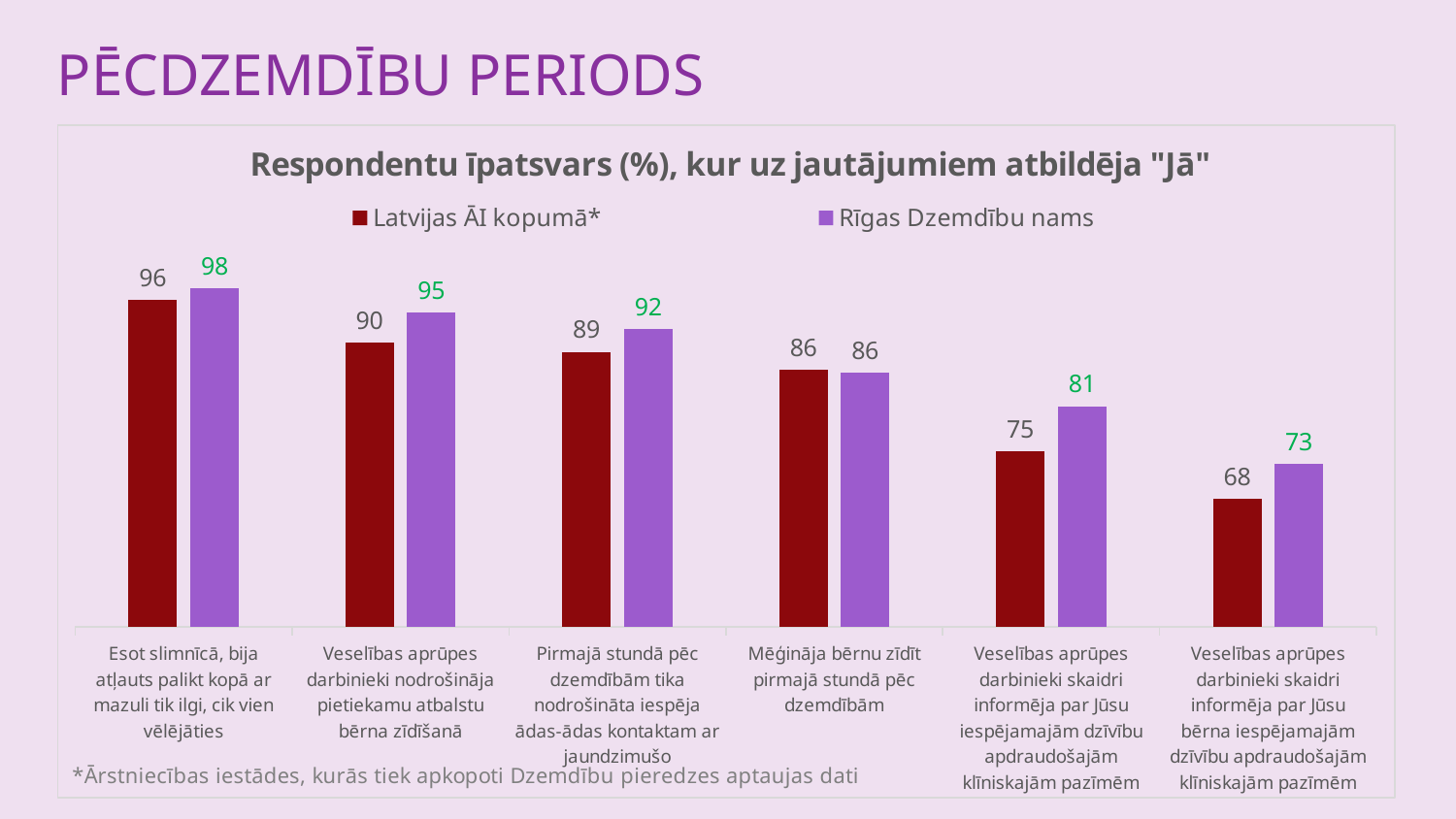
Which category has the highest value for "Rīgas Dzemdību nams"? Esot slimnīcā, bija atļauts palikt kopā ar mazuli tik ilgi, cik vien vēlējāties How many categories are shown on the x axis of the chart? 6 What is the value for "Rīgas Dzemdību nams" in the category "Esot slimnīcā, bija atļauts palikt kopā ar mazuli tik ilgi, cik vien vēlējāties"? 98 What is the value for "Rīgas Dzemdību nams" in the category "Mēģināja bērnu zīdīt pirmajā stundā pēc dzemdībām"? 86 What is the title of the chart? Respondentu īpatsvars (%), kur uz jautājumiem atbildēja "Jā" What kind of chart is shown on the slide? Bar chart What is the value for "Latvijas ĀI kopumā*" in the category "Veselības aprūpes darbinieki nodrošināja pietiekamu atbalstu bērna zīdīšanā"? 90 What is the difference between "Rīgas Dzemdību nams" and "Latvijas ĀI kopumā*" in the category "Veselības aprūpes darbinieki skaidri informēja par Jūsu iespējamajām dzīvību apdraudošajām klīniskajām pazīmēm"? 6 Which category has the lowest value for "Latvijas ĀI kopumā*"? Veselības aprūpes darbinieki skaidri informēja par Jūsu bērna iespējamajām dzīvību apdraudošajām klīniskajām pazīmēm How many series does the chart legend list? 2 In the category "Pirmajā stundā pēc dzemdībām tika nodrošināta iespēja ādas-ādas kontaktam ar jaundzimušo", which series has the larger value? Rīgas Dzemdību nams What is the difference between "Rīgas Dzemdību nams" and "Latvijas ĀI kopumā*" in the category "Veselības aprūpes darbinieki nodrošināja pietiekamu atbalstu bērna zīdīšanā"? 5